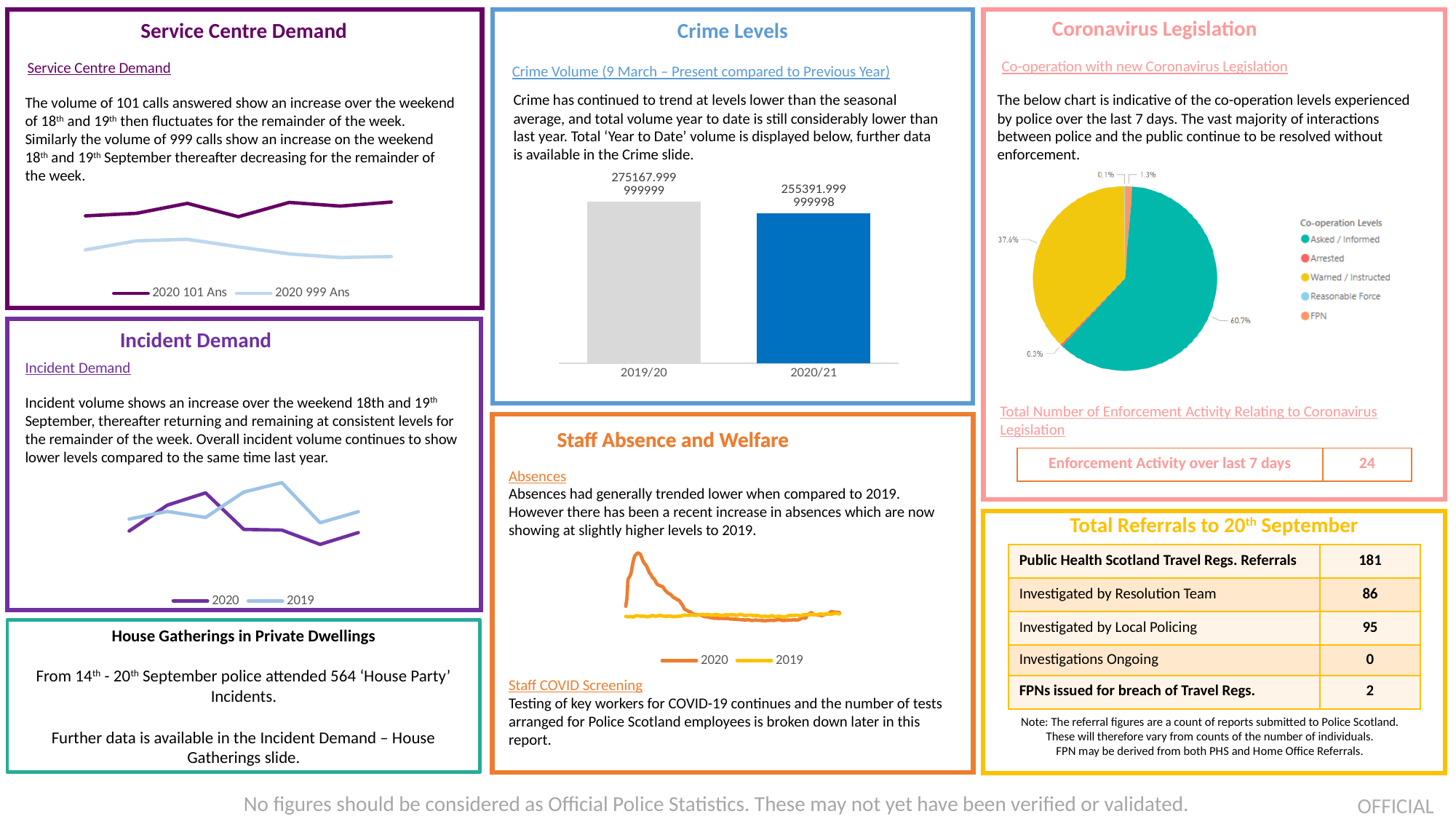
How many categories are shown in the Crime Levels bar chart? 2 In the Coronavirus Legislation pie chart, what share is labelled for the Asked / Informed slice? 60.7% What kind of chart is used in the Crime Levels panel? Bar chart What kind of chart is shown in the Staff Absence and Welfare panel? Line chart What are the two series named in the legend of the Incident Demand chart? 2020 and 2019 In the Coronavirus Legislation pie chart, which co-operation level has the largest slice? Asked / Informed How many co-operation levels does the legend of the Coronavirus Legislation pie chart list? 5 In the Coronavirus Legislation pie chart, what share is labelled for the Warned / Instructed slice? 37.6% In the Service Centre Demand line chart, which series is plotted higher, 2020 101 Ans or 2020 999 Ans? 2020 101 Ans In the Crime Levels bar chart, which year has the higher crime volume, 2019/20 or 2020/21? 2019/20 How many series does the legend of the Service Centre Demand line chart list? 2 What kind of chart is shown in the Coronavirus Legislation panel? Pie chart